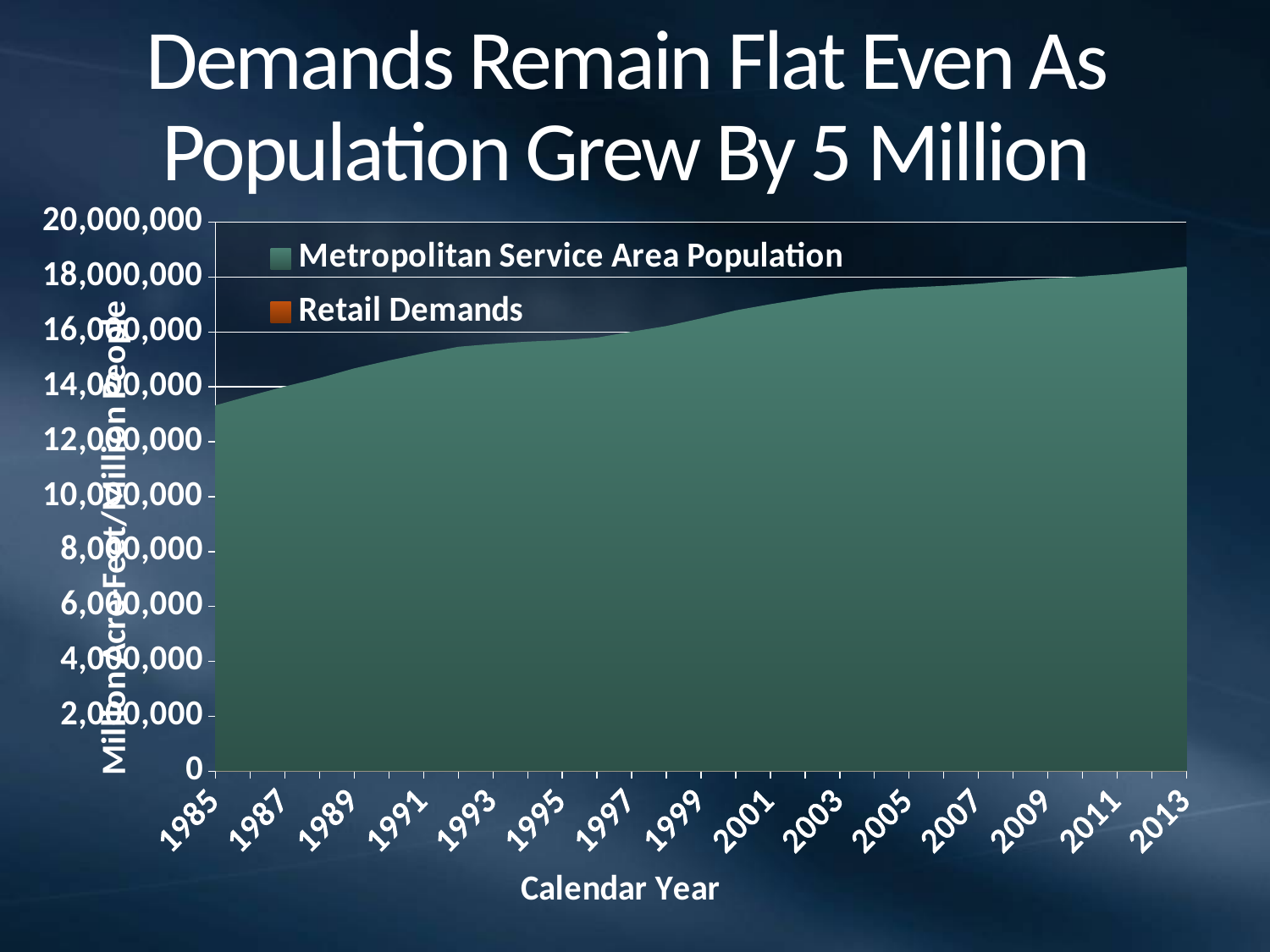
How many series does the legend list? 2 What kind of chart is shown on the slide? Area chart Is the Metropolitan Service Area Population in 1985 greater or less than 14,000,000? less Is the Metropolitan Service Area Population in 1993 greater or less than 14,000,000? greater Which year has the larger Metropolitan Service Area Population, 1989 or 2009? 2009 Is the Metropolitan Service Area Population in 2013 greater or less than 16,000,000? greater What is the title of the x axis? Calendar Year In which year is the Metropolitan Service Area Population lowest? 1985 Does the Metropolitan Service Area Population rise or fall from 1985 to 2013? Rise In which year is the Metropolitan Service Area Population highest? 2013 Which series are listed in the legend? Metropolitan Service Area Population and Retail Demands